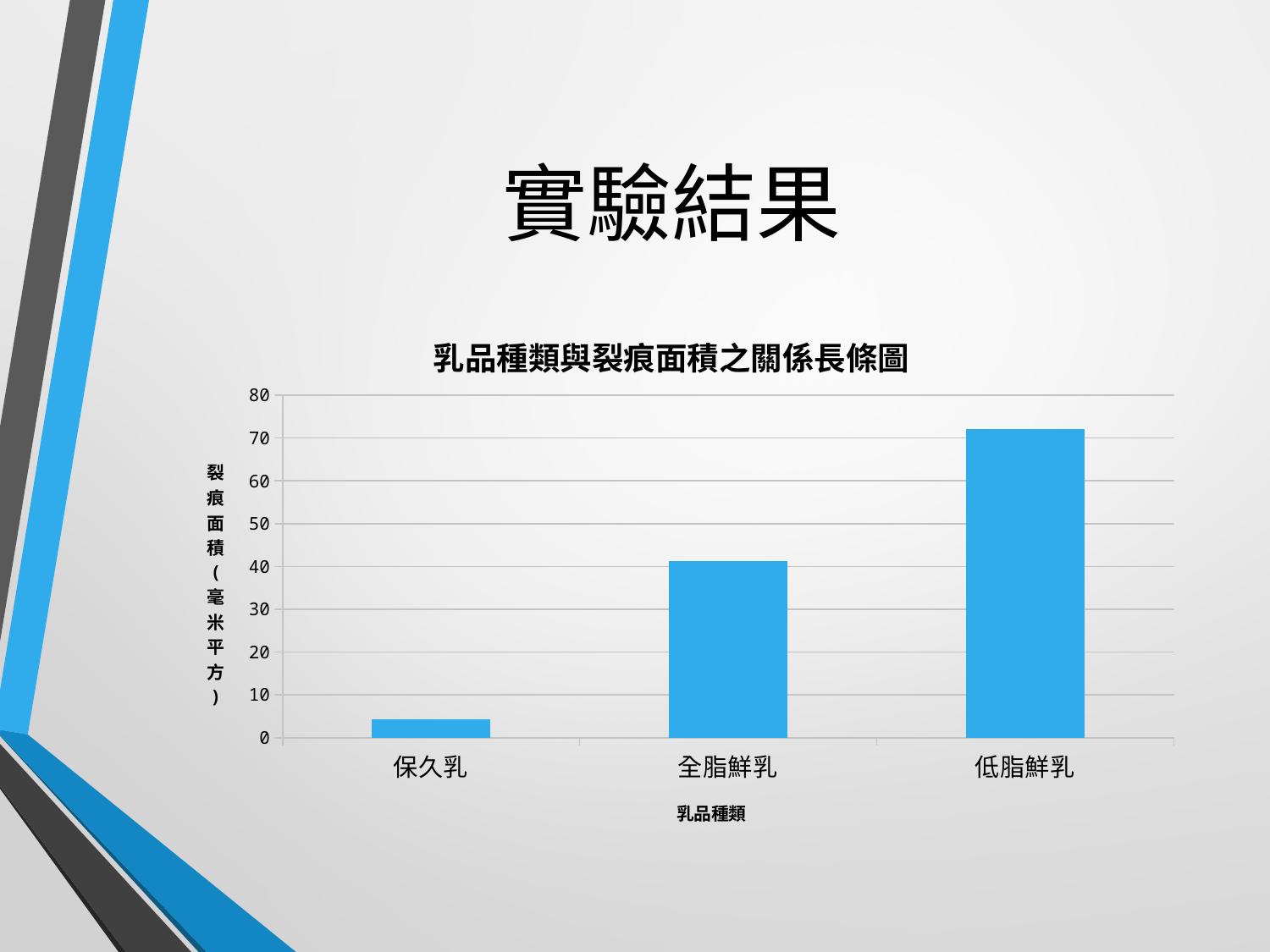
Is the value for 低脂鮮乳 greater or less than 70? greater Is the value for 保久乳 greater or less than 10? less Which has a larger value, 全脂鮮乳 or 低脂鮮乳? 低脂鮮乳 Do the bar values rise or fall from left to right across the x axis? rise Is the value for 全脂鮮乳 greater or less than 40? greater What kind of chart is shown on the slide? bar chart How many categories are shown on the x axis of the chart? 3 Which has a larger value, 保久乳 or 全脂鮮乳? 全脂鮮乳 What is the title of the chart? 乳品種類與裂痕面積之關係長條圖 Which category has the highest crack area (裂痕面積) in the chart? 低脂鮮乳 What is the label of the x axis of the chart? 乳品種類 Which category has the lowest crack area (裂痕面積) in the chart? 保久乳